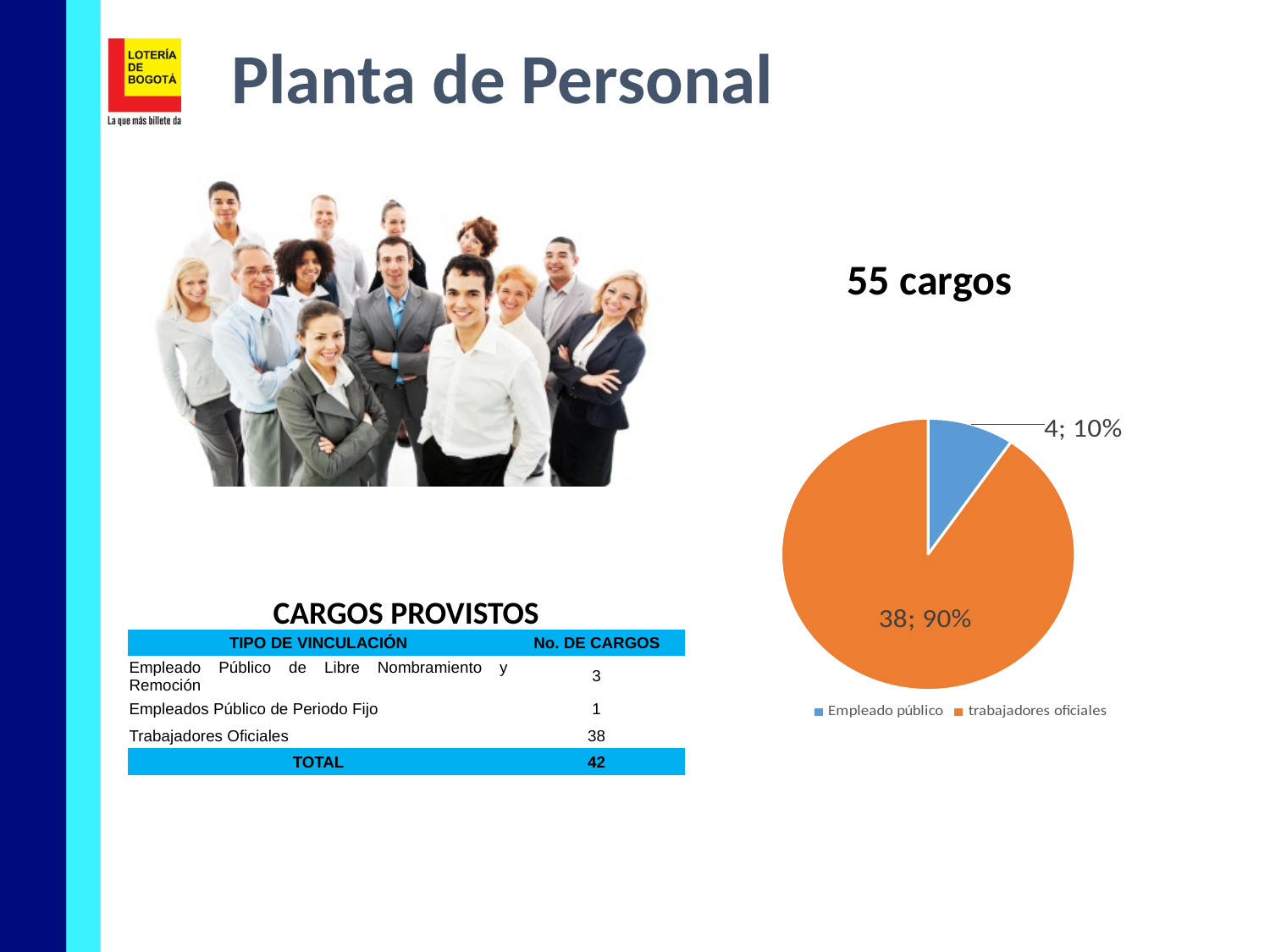
What kind of chart is shown on the slide? pie chart In the pie chart, what share does Empleado público represent? 10% In the pie chart, what is the difference between the values for trabajadores oficiales and Empleado público? 34 Which slice of the pie chart is the smallest? Empleado público What colour is the trabajadores oficiales slice in the pie chart? orange In the pie chart, what is the value for Empleado público? 4 How many slices does the pie chart have? 2 How many entries does the pie chart's legend list? 2 In the pie chart, what is the value for trabajadores oficiales? 38 In the pie chart, which is larger: Empleado público or trabajadores oficiales? trabajadores oficiales Which slice of the pie chart is the largest? trabajadores oficiales In the pie chart, what share does trabajadores oficiales represent? 90%